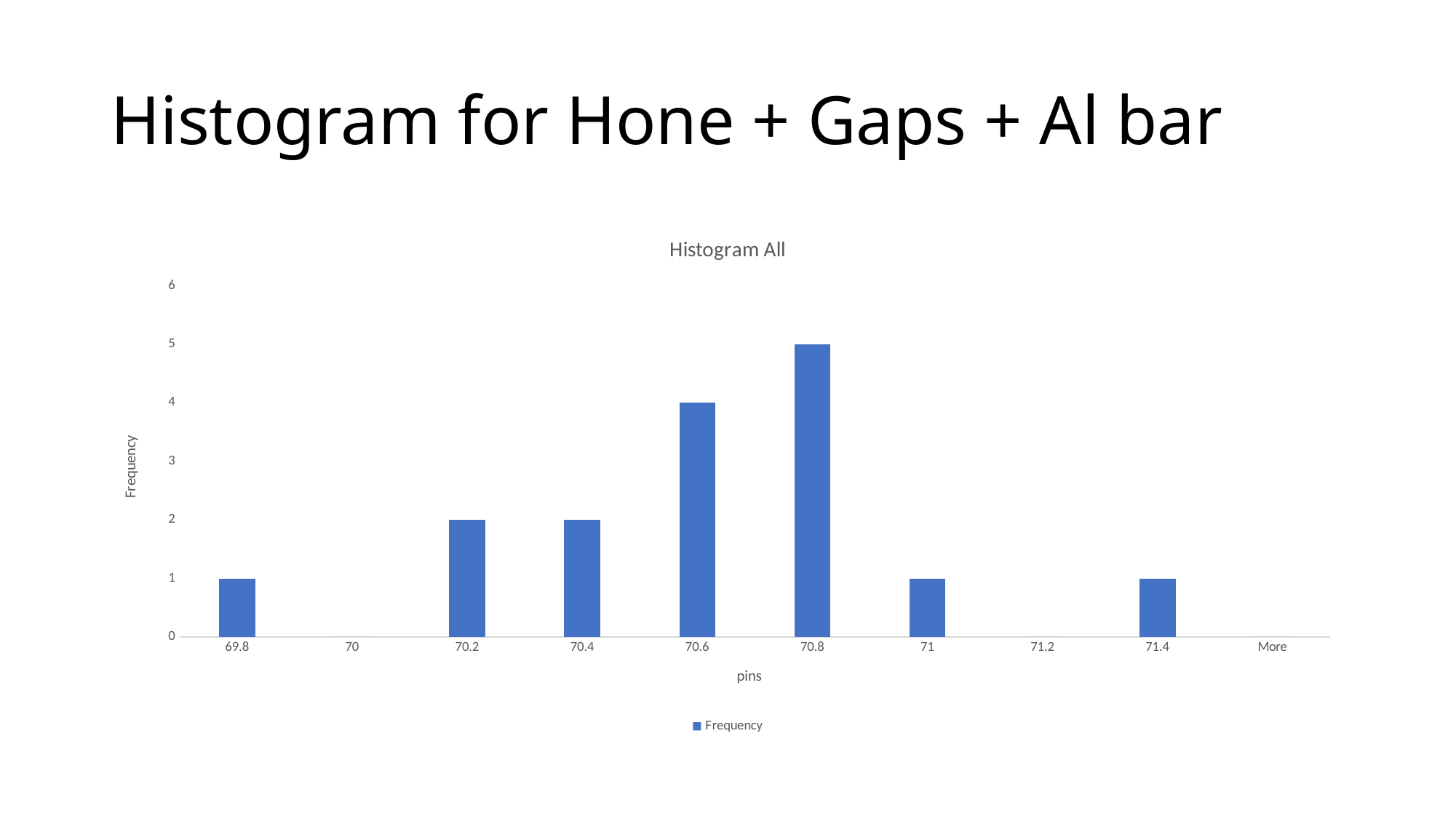
What is the frequency for the 70.6 bin? 4 What is the label of the x axis? pins What is the frequency for the 70.8 bin? 5 Is the frequency for the 70.8 bin greater or less than 4? greater What kind of chart is shown? bar chart How many bins are shown on the x axis? 10 What is the frequency for the 69.8 bin? 1 Which has a higher frequency, the 70.2 bin or the 70.6 bin? 70.6 What is the title of the chart? Histogram All How many series does the legend list? 1 What is the difference in frequency between the 70.8 bin and the 70.6 bin? 1 Which bin has the highest frequency? 70.8